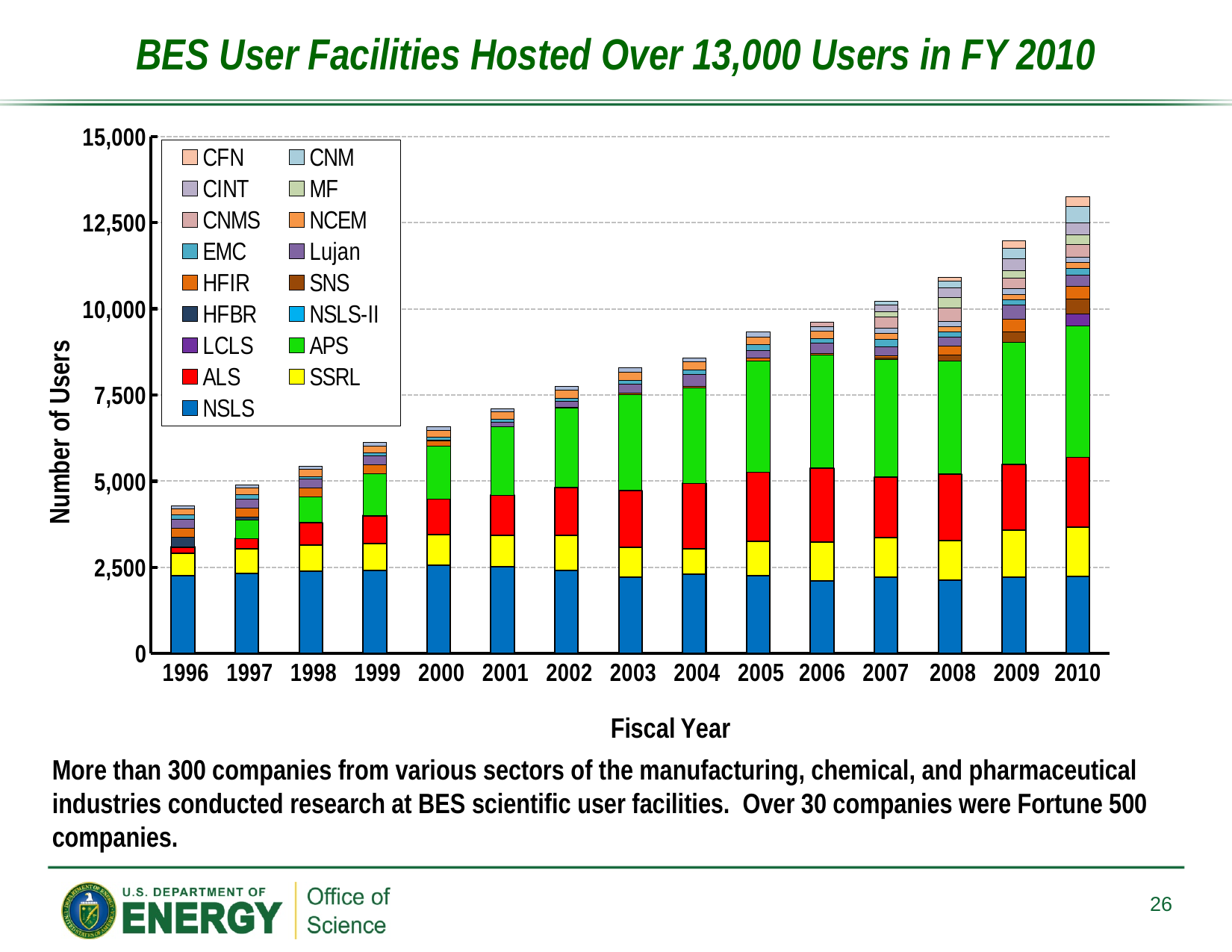
What is the label on the y axis of the chart? Number of Users How many series does the chart's legend list? 17 Is the total number of users in 2010 greater or less than 12,500? greater How many fiscal years are shown along the x axis of the chart? 15 Do the total number of users generally rise or fall from 1996 to 2010? Rise Is the total number of users in 2005 greater or less than 10,000? less What kind of chart is shown on the slide? Stacked bar chart Is the total number of users in 1996 greater or less than 5,000? less Which fiscal year has the shortest stacked bar (the fewest users)? 1996 Which fiscal year has the tallest stacked bar (the most users)? 2010 What is the title of the slide containing the chart? BES User Facilities Hosted Over 13,000 Users in FY 2010 Which year had more total users, 2010 or 1996? 2010